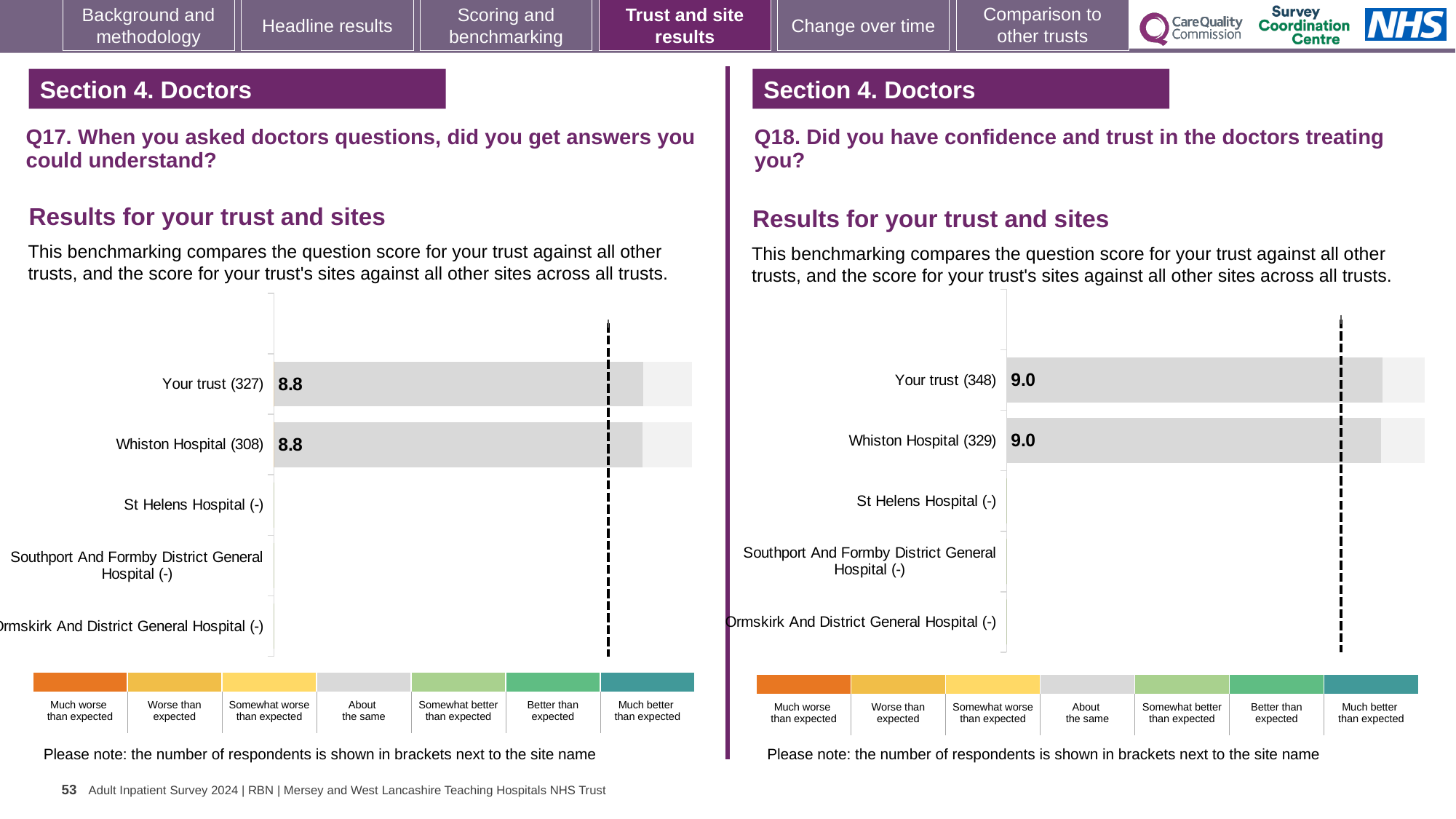
What kind of chart is the Q17 chart on the left? Bar chart How many benchmark categories are shown in the colour key below the Q17 chart on the left? 7 In the Q17 chart on the left, what is the score for Whiston Hospital? 8.8 In the Q17 chart on the left, what is the difference between the scores for Your trust and Whiston Hospital? 0.0 In the Q18 chart on the right, what is the score for Whiston Hospital? 9.0 In the Q18 chart on the right, what is the score for Your trust? 9.0 In the Q17 chart on the left, what is the score for Your trust? 8.8 In the Q17 chart on the left, how many categories have a plotted bar with a score? 2 In the Q18 chart on the right, how many respondents are shown in brackets for Your trust? 348 In the Q18 chart on the right, which category has the larger score, Your trust or Whiston Hospital? They are equal (9.0) In the Q17 chart on the left, how many respondents are shown in brackets for Whiston Hospital? 308 How many site/trust categories are listed on the y axis of the Q18 chart on the right? 5